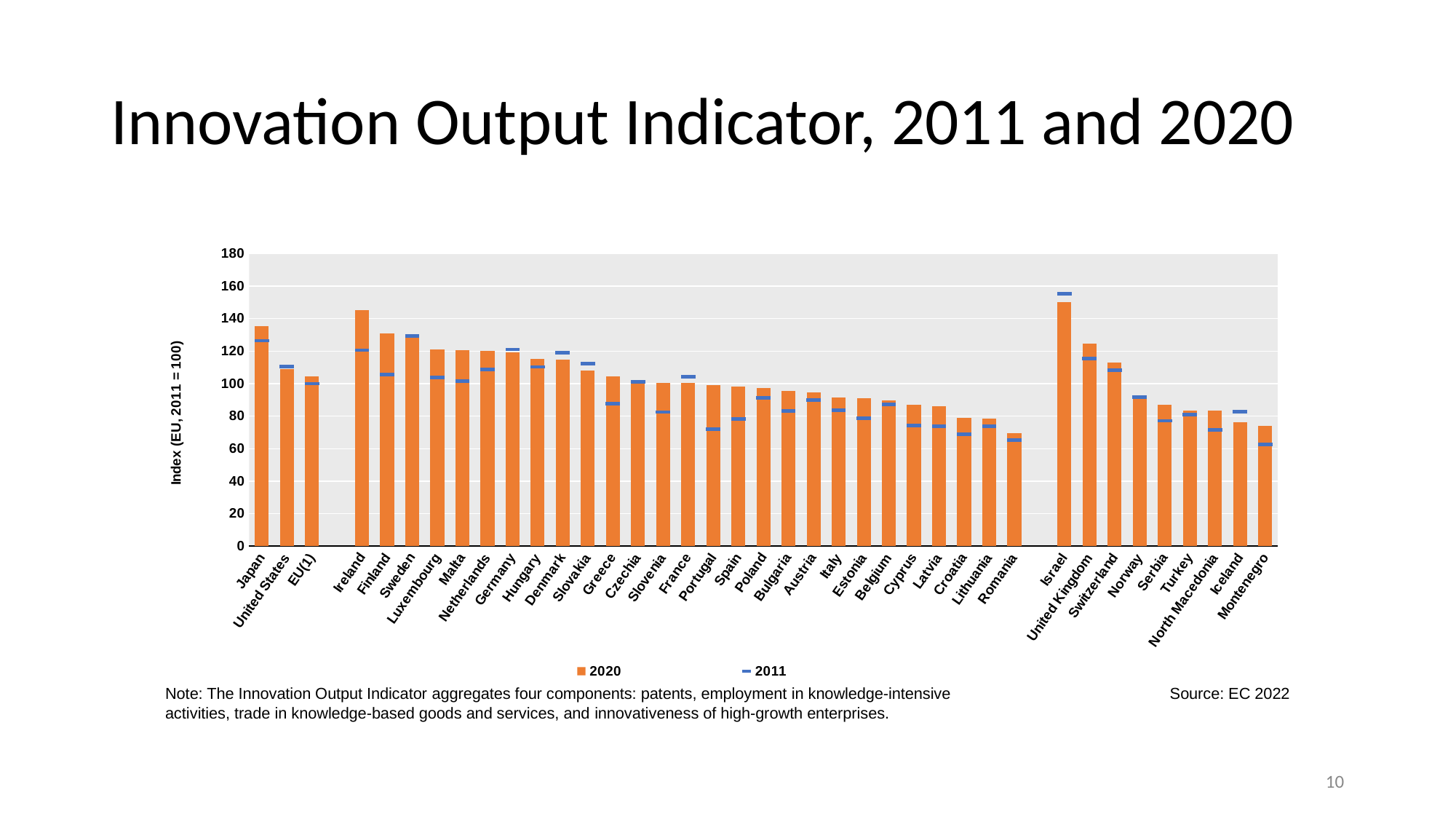
What kind of chart is shown on the slide? bar chart Which country has the lowest 2020 bar? Romania How many countries or regions are shown on the x axis? 39 Which has the larger 2020 value, Israel or the United Kingdom? Israel Which has the larger 2020 value, Japan or the United States? Japan How many series does the legend list? 2 What is the label on the vertical axis? Index (EU, 2011 = 100) Which two series are listed in the legend? 2020 and 2011 Is the 2020 value for Ireland greater or less than 140? greater Is the 2020 value for Montenegro greater or less than 80? less Which country has the highest 2020 bar? Israel Is the 2020 value for Japan greater or less than 120? greater